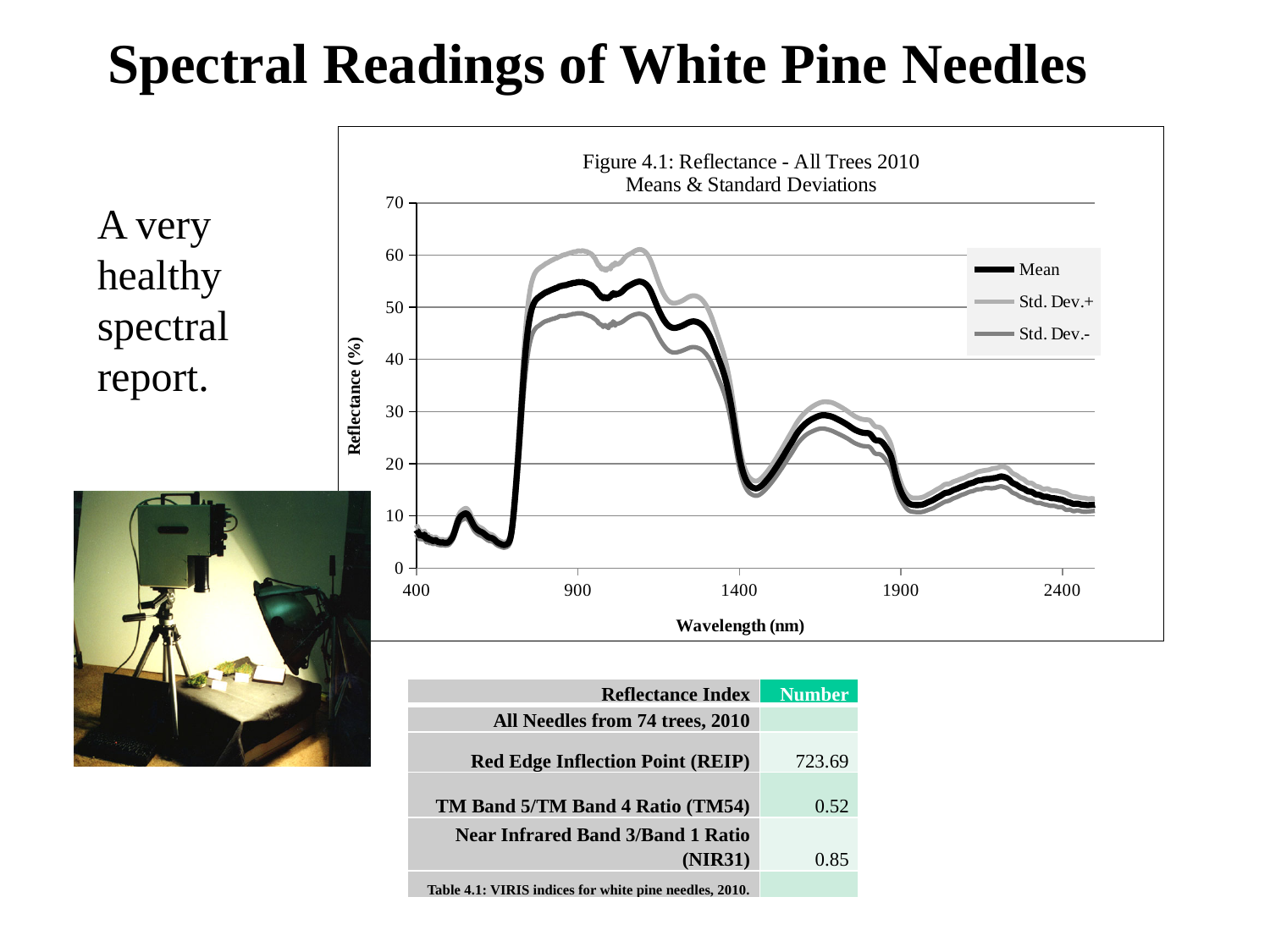
At 900 nm, which series has the higher reflectance, Std. Dev.+ or Std. Dev.-? Std. Dev.+ What kind of chart is shown in Figure 4.1? line chart How many series does the legend of the Figure 4.1 chart list? 3 Does the Mean reflectance rise or fall between 900 nm and 1400 nm? fall Is the Std. Dev.- reflectance at 900 nm greater or less than 40? greater Which series has the lowest reflectance at 900 nm? Std. Dev.- Is the Mean reflectance at 2400 nm greater or less than 20? less What is the title of the chart on the slide? Figure 4.1: Reflectance - All Trees 2010 Means & Standard Deviations Is the Std. Dev.+ reflectance at 900 nm greater or less than 50? greater What is the label of the y axis of the chart? Reflectance (%)